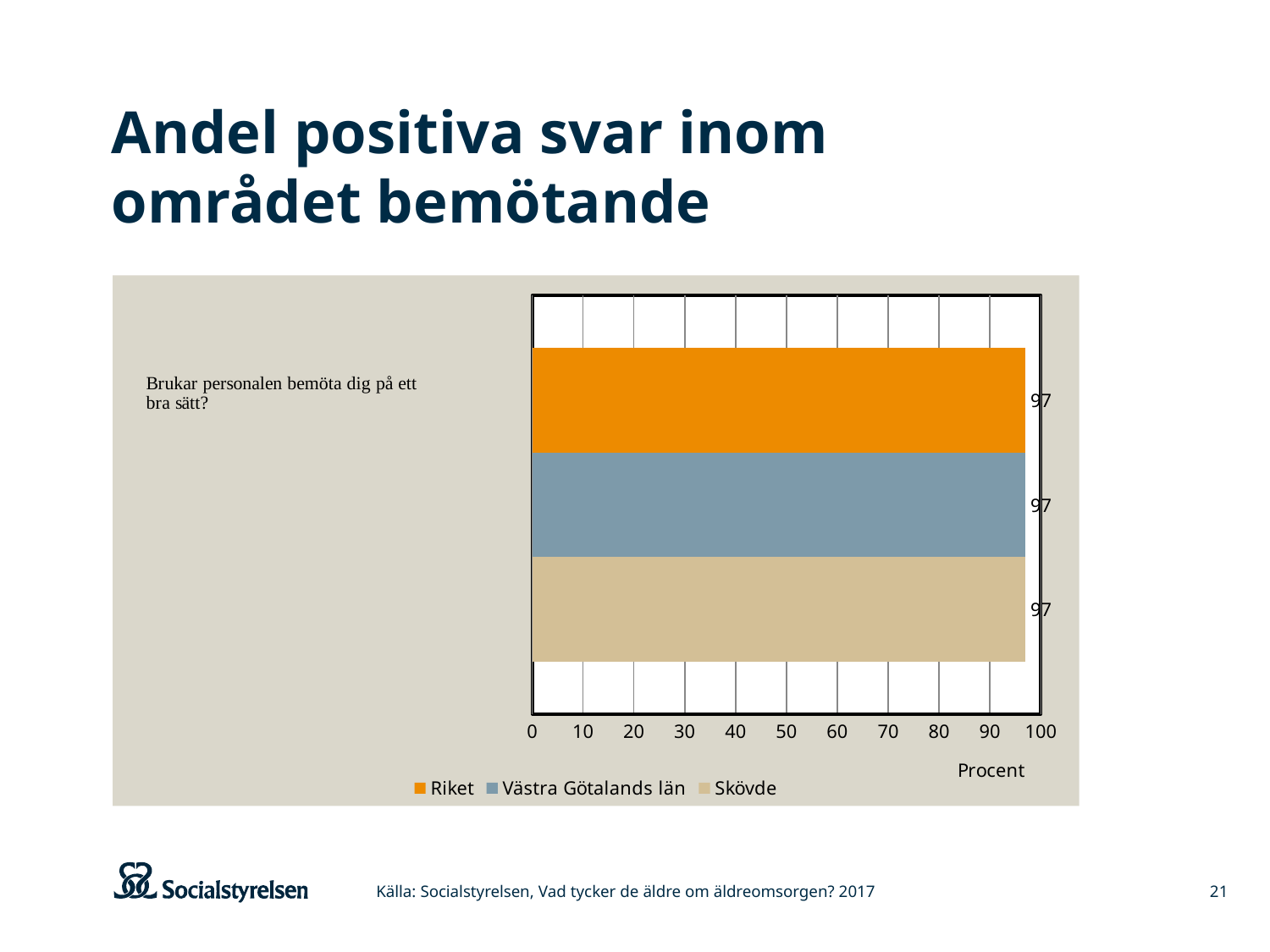
What is the value for Riket on the question "Brukar personalen bemöta dig på ett bra sätt?"? 97 Is the value for Riket greater or less than 100? less What kind of chart is shown on the slide? Bar chart How many series does the legend list? 3 What is the value for Skövde on the question "Brukar personalen bemöta dig på ett bra sätt?"? 97 What is the difference between the values for Riket and Skövde? 0 Which series is shown in orange in the chart? Riket What is the label on the horizontal axis of the chart? Procent Is the value for Skövde greater or less than 90? greater How many survey questions (categories) are plotted in the chart? 1 What is the value for Västra Götalands län on the question "Brukar personalen bemöta dig på ett bra sätt?"? 97